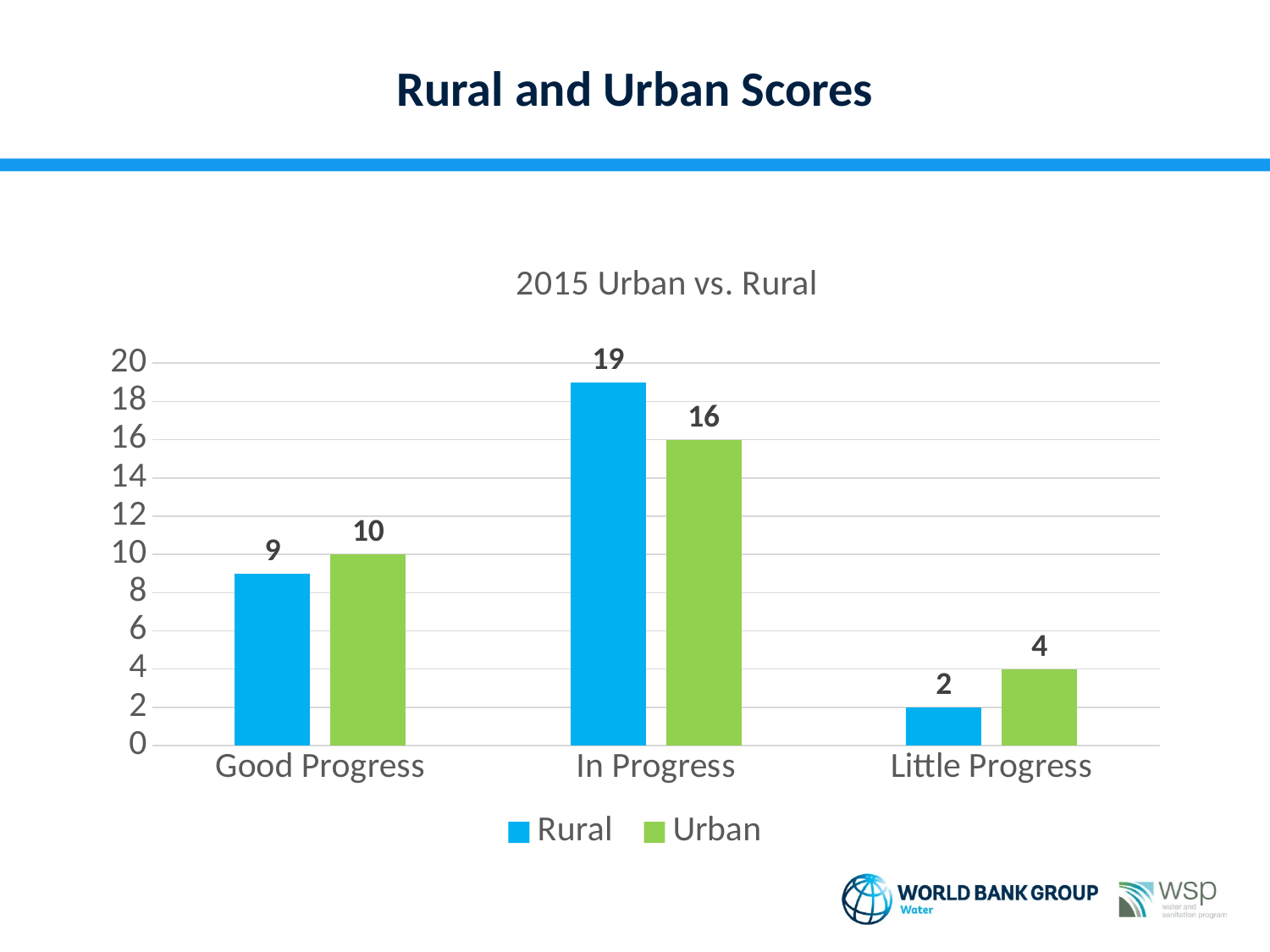
What is the title of the chart? 2015 Urban vs. Rural How many categories are shown on the x axis? 3 Which category has the highest Rural value? In Progress What is the difference between the Urban and Rural values for Little Progress? 2 What is the Urban value for Good Progress? 10 What kind of chart is shown on the slide? Bar chart What is the Urban value for Little Progress? 4 What is the Rural value for In Progress? 19 Which category has the lowest Urban value? Little Progress How many series does the legend list? 2 Which is larger for Good Progress, the Rural value or the Urban value? Urban What is the difference between the Rural and Urban values for In Progress? 3